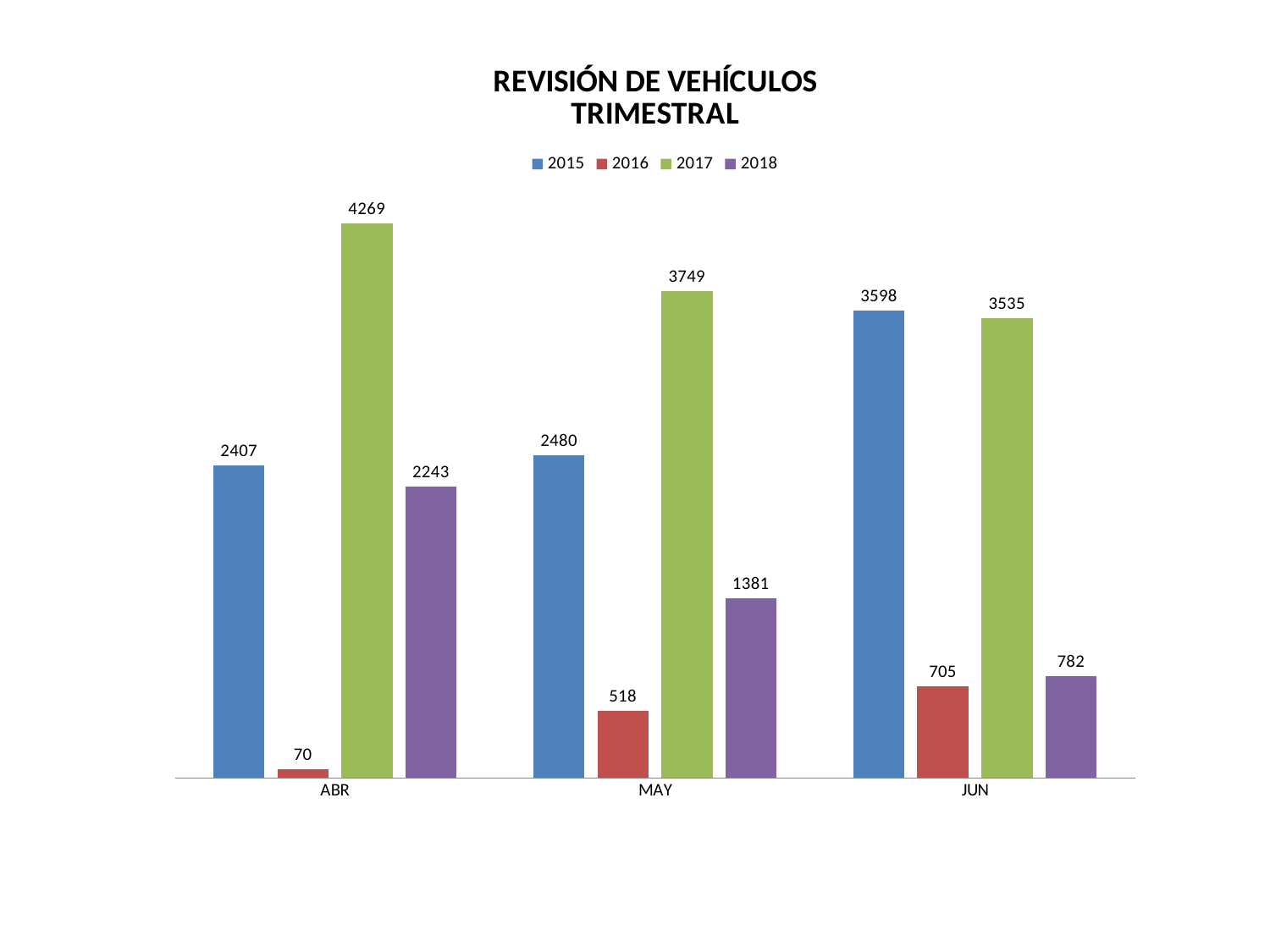
What is the value for 2017 in ABR? 4269 What is the title of the chart? REVISIÓN DE VEHÍCULOS TRIMESTRAL Which month has the lowest value for 2016? ABR What kind of chart is shown? bar chart Do the values for 2016 rise or fall from ABR to JUN? rise What is the value for 2018 in JUN? 782 Which month has the highest value for 2015? JUN How many months are shown on the x axis? 3 What is the difference between the 2017 and 2015 values in MAY? 1269 What is the value for 2016 in MAY? 518 How many series does the legend list? 4 Which is larger in JUN, the value for 2015 or the value for 2017? 2015